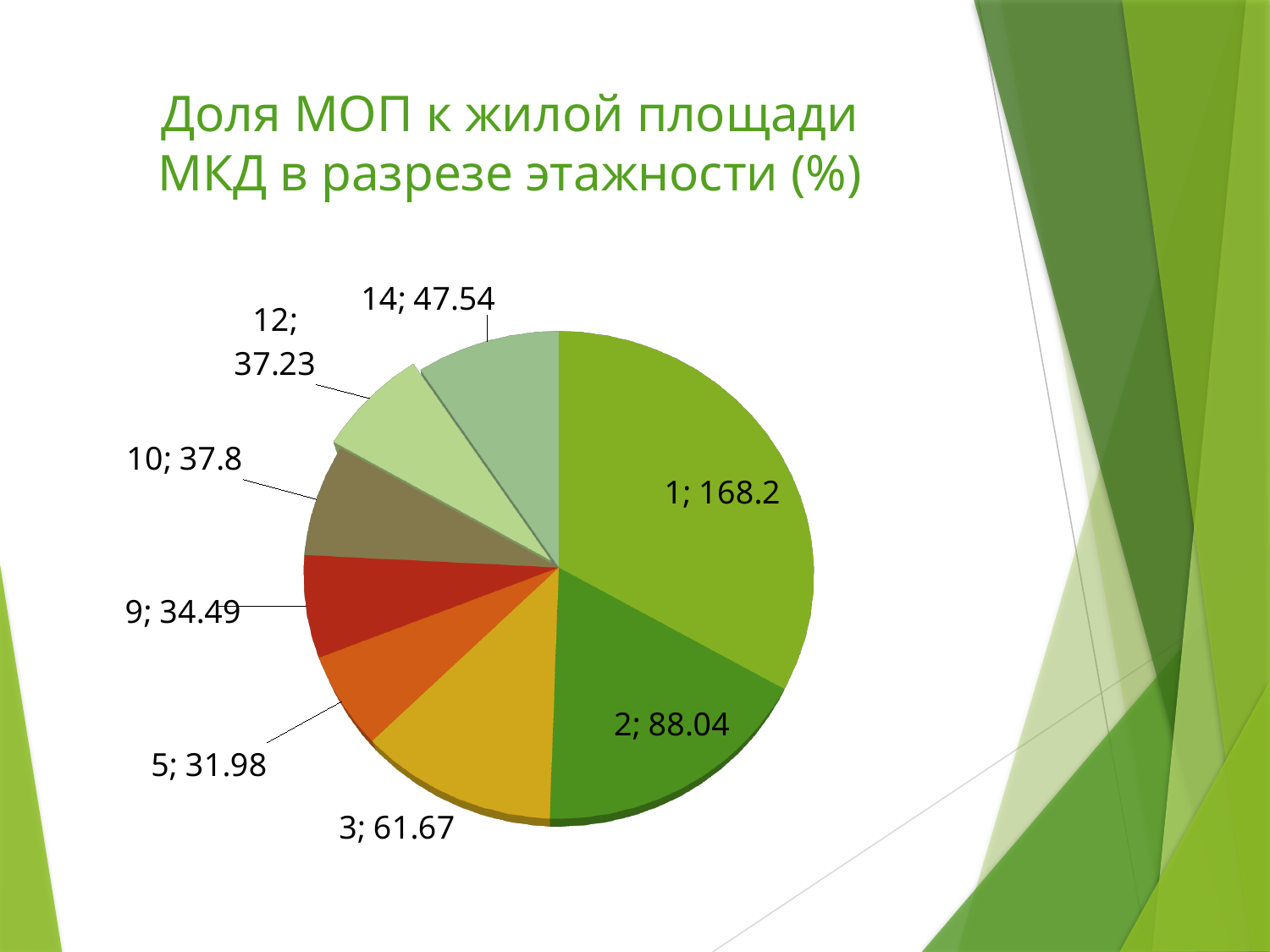
Which has the larger value, category 3 or category 14? 3 What is the difference between the values for category 1 and category 2? 80.16 What is the value shown for category 14 in the pie chart? 47.54 What is the title of the chart on the slide? Доля МОП к жилой площади МКД в разрезе этажности (%) What is the value shown for category 12 in the pie chart? 37.23 What kind of chart is shown on the slide? pie chart What is the value shown for category 1 in the pie chart? 168.2 What is the value shown for category 9 in the pie chart? 34.49 What is the difference between the values for category 14 and category 10? 9.74 How many slices does the pie chart have? 8 Which category has the largest slice in the pie chart? 1 Which category has the smallest slice in the pie chart? 5